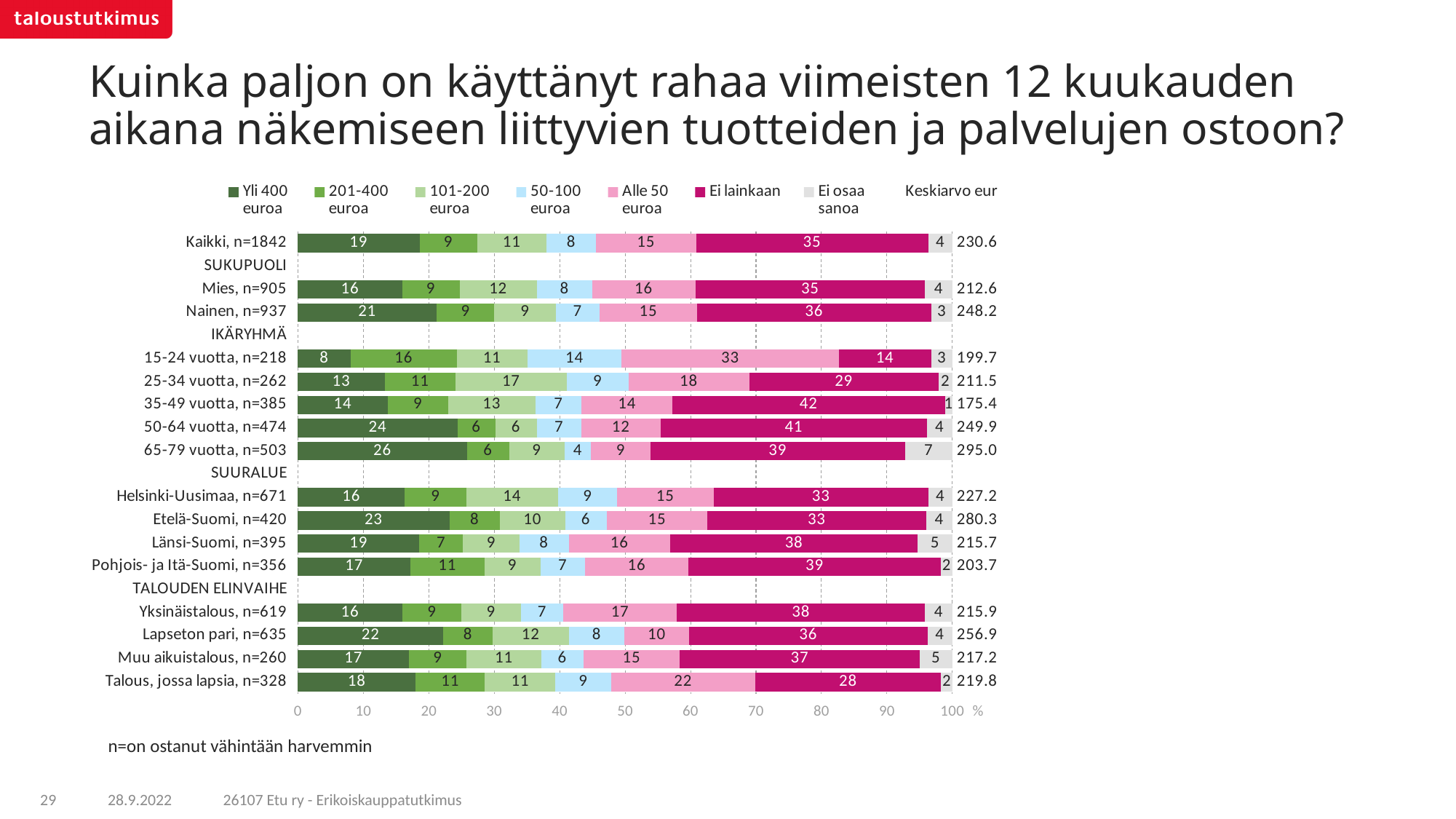
Which group has the highest 'Ei lainkaan' share? 35-49 vuotta, n=385 What kind of chart is shown on the slide? Stacked bar chart What is the value of 'Alle 50 euroa' for the group 'Talous, jossa lapsia, n=328'? 22 How many spending categories does the legend list, excluding the 'Keskiarvo eur' column label? 7 How many groups (rows with bars) are plotted in the chart? 16 What is the difference between the 'Yli 400 euroa' values for 'Nainen, n=937' and 'Mies, n=905'? 5 Which group has the lowest Keskiarvo eur value? 35-49 vuotta, n=385 Which group has the highest Keskiarvo eur value? 65-79 vuotta, n=503 Which group has the larger 'Alle 50 euroa' value: '15-24 vuotta, n=218' or '25-34 vuotta, n=262'? 15-24 vuotta, n=218 What is the value of 'Ei lainkaan' for the group 'Kaikki, n=1842'? 35 What is the Keskiarvo eur value for the group '65-79 vuotta, n=503'? 295.0 What is the Keskiarvo eur value for 'Etelä-Suomi, n=420'? 280.3